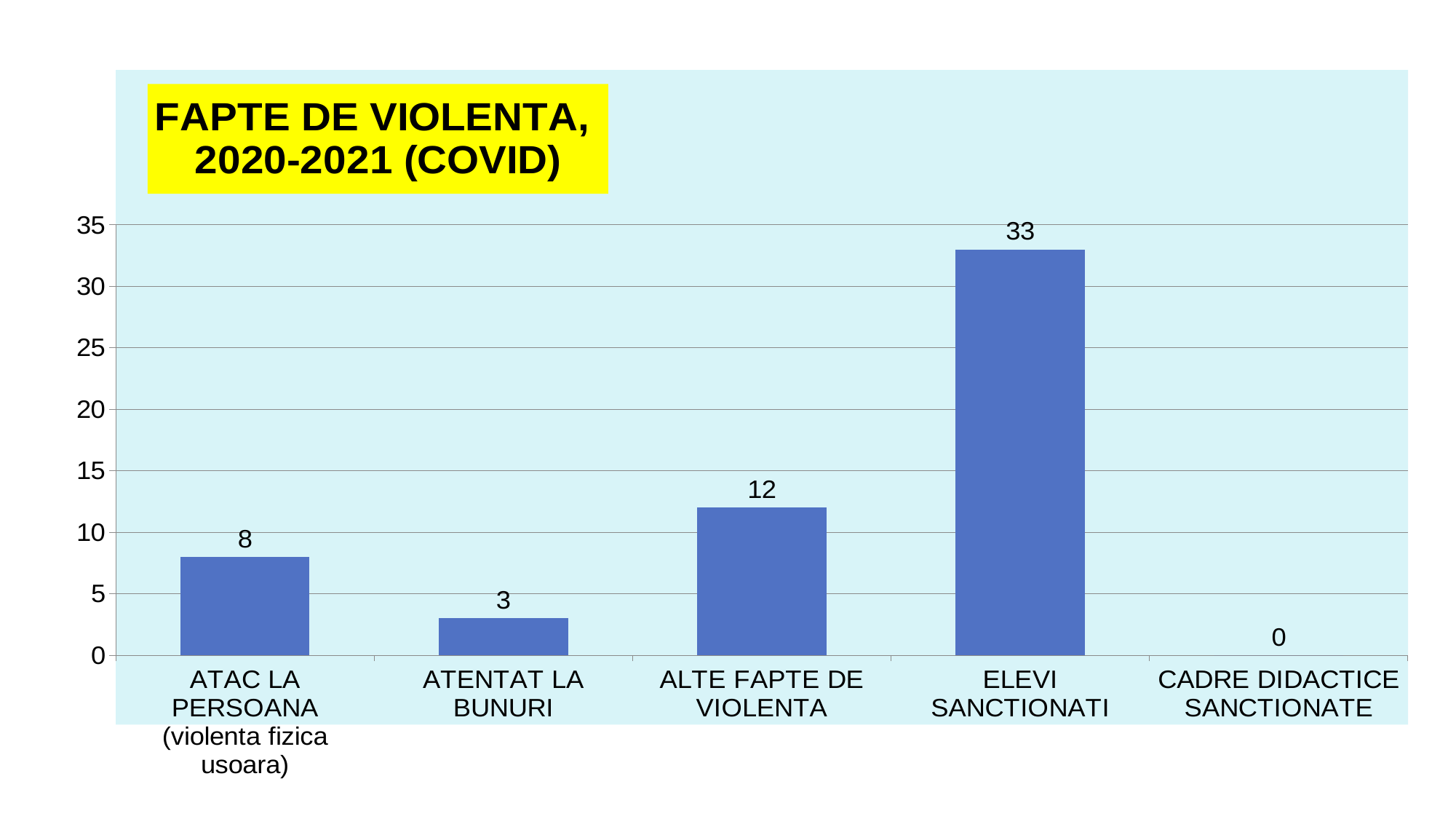
What is the title of the chart? FAPTE DE VIOLENTA, 2020-2021 (COVID) Which category has the highest value? ELEVI SANCTIONATI What is the value for ATENTAT LA BUNURI? 3 What is the value for ELEVI SANCTIONATI? 33 What is the value for ALTE FAPTE DE VIOLENTA? 12 What is the value for CADRE DIDACTICE SANCTIONATE? 0 How many categories are shown on the x axis? 5 What kind of chart is shown on the slide? bar chart Which is larger, the value for ATAC LA PERSOANA (violenta fizica usoara) or the value for ATENTAT LA BUNURI? ATAC LA PERSOANA (violenta fizica usoara) Which category has the lowest value? CADRE DIDACTICE SANCTIONATE What is the difference between the values for ELEVI SANCTIONATI and ALTE FAPTE DE VIOLENTA? 21 Is the value for ALTE FAPTE DE VIOLENTA greater or less than 10? greater